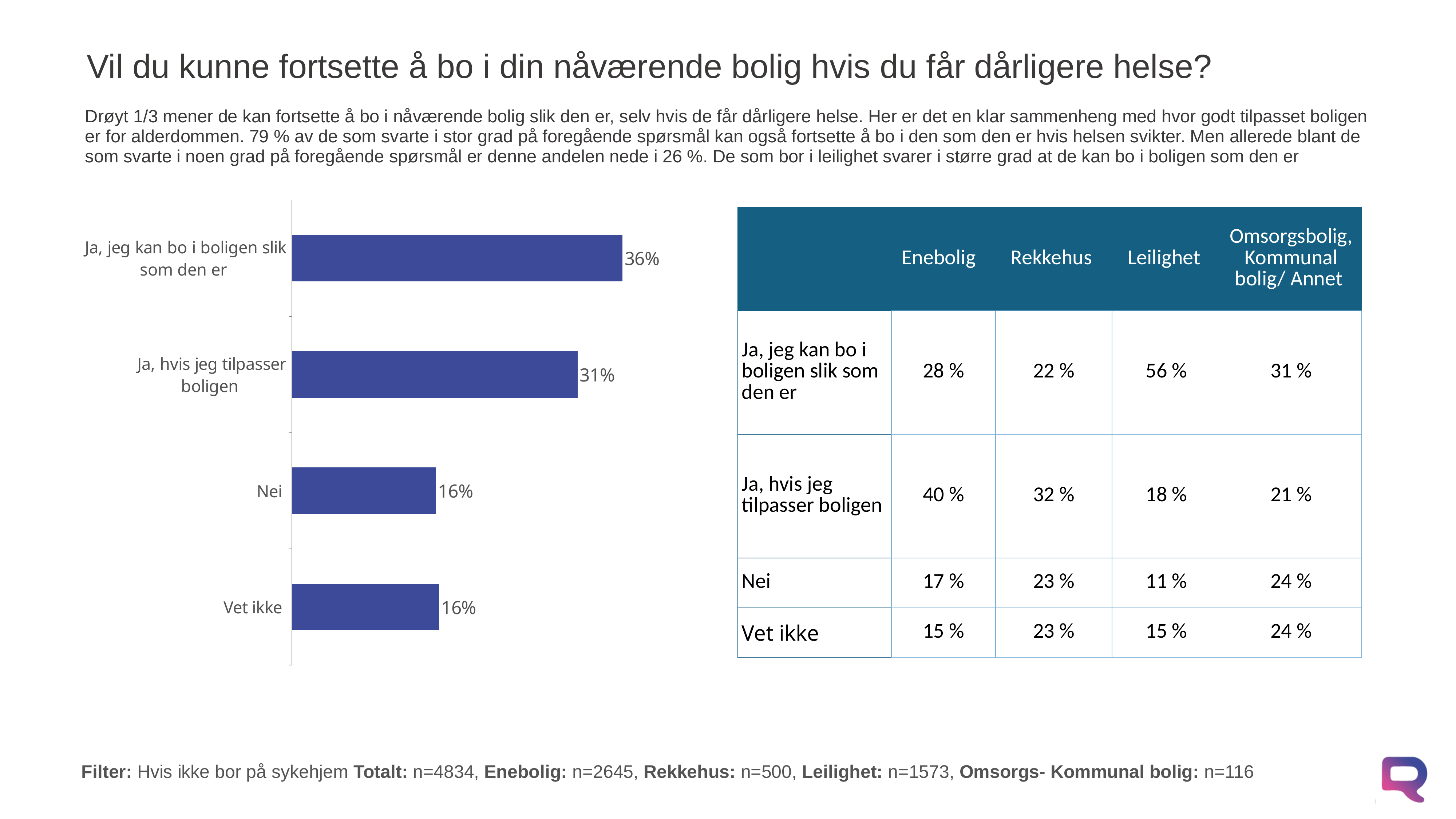
What is the value for "Vet ikke" in the bar chart? 16% What is the difference between "Ja, hvis jeg tilpasser boligen" and "Nei" in the bar chart? 15 percentage points What is the value for "Ja, hvis jeg tilpasser boligen" in the bar chart? 31% Which is larger in the bar chart: "Ja, hvis jeg tilpasser boligen" or "Vet ikke"? Ja, hvis jeg tilpasser boligen What type of chart is shown on the slide? bar chart Do the values in the bar chart rise or fall from the top bar to the bottom bar? fall What is the difference between "Ja, jeg kan bo i boligen slik som den er" and "Ja, hvis jeg tilpasser boligen" in the bar chart? 5 percentage points What colour are the bars in the bar chart? blue What is the value for "Ja, jeg kan bo i boligen slik som den er" in the bar chart? 36% How many categories are shown in the bar chart? 4 Which category has the highest value in the bar chart? Ja, jeg kan bo i boligen slik som den er What is the value for "Nei" in the bar chart? 16%